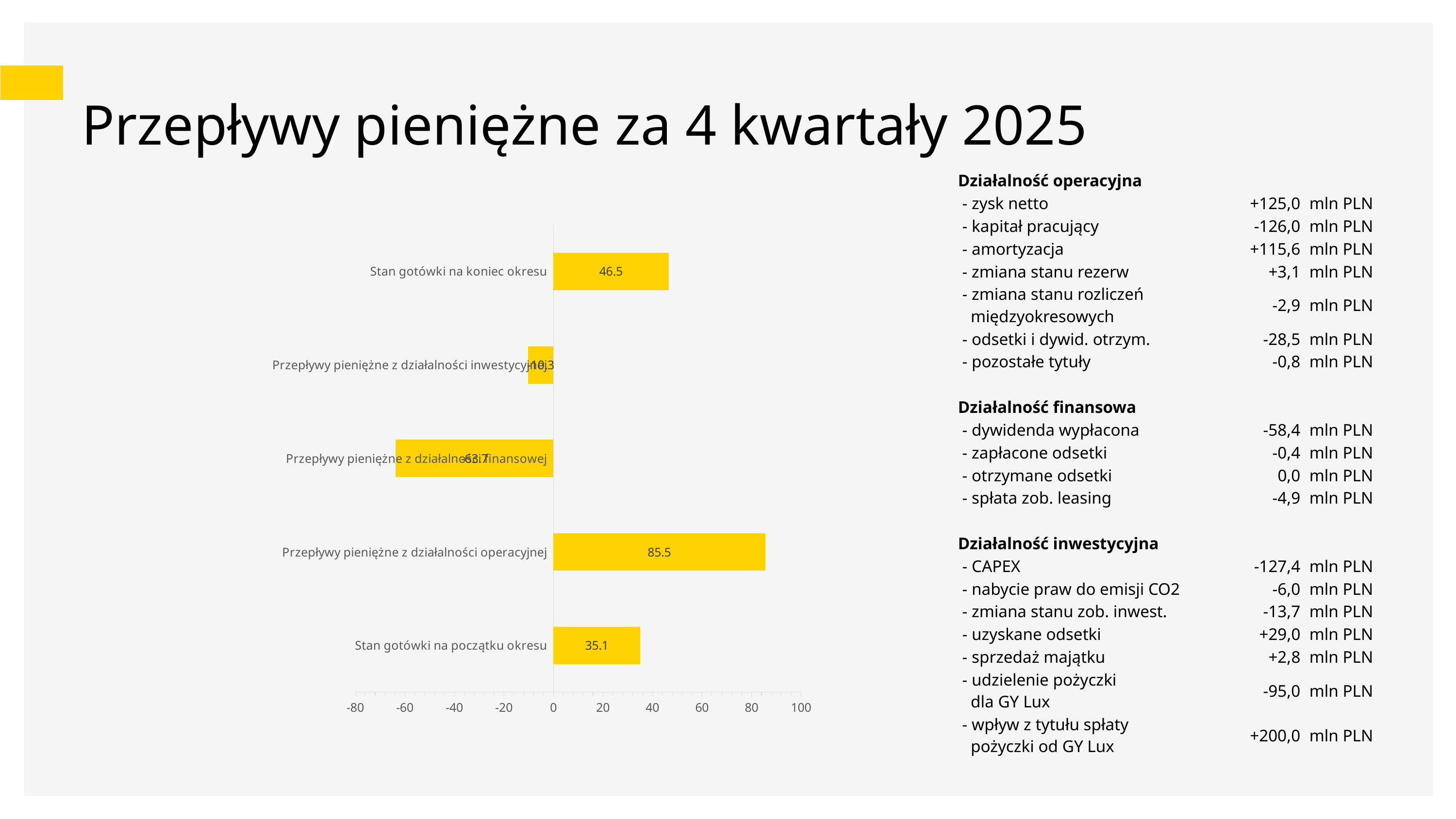
Is the value for Przepływy pieniężne z działalności finansowej greater or less than -40? less Is the value for Przepływy pieniężne z działalności inwestycyjnej greater or less than -20? greater What is the value for Stan gotówki na koniec okresu? 46.5 What is the value for Przepływy pieniężne z działalności operacyjnej? 85.5 What is the value for Stan gotówki na początku okresu? 35.1 Which is larger, Stan gotówki na koniec okresu or Stan gotówki na początku okresu? Stan gotówki na koniec okresu What is the difference between Przepływy pieniężne z działalności operacyjnej and Stan gotówki na koniec okresu? 39.0 Which category has the highest value? Przepływy pieniężne z działalności operacyjnej What is the difference between Stan gotówki na koniec okresu and Stan gotówki na początku okresu? 11.4 How many categories are shown in the chart? 5 Which category has the lowest value? Przepływy pieniężne z działalności finansowej What kind of chart is shown on the slide? bar chart